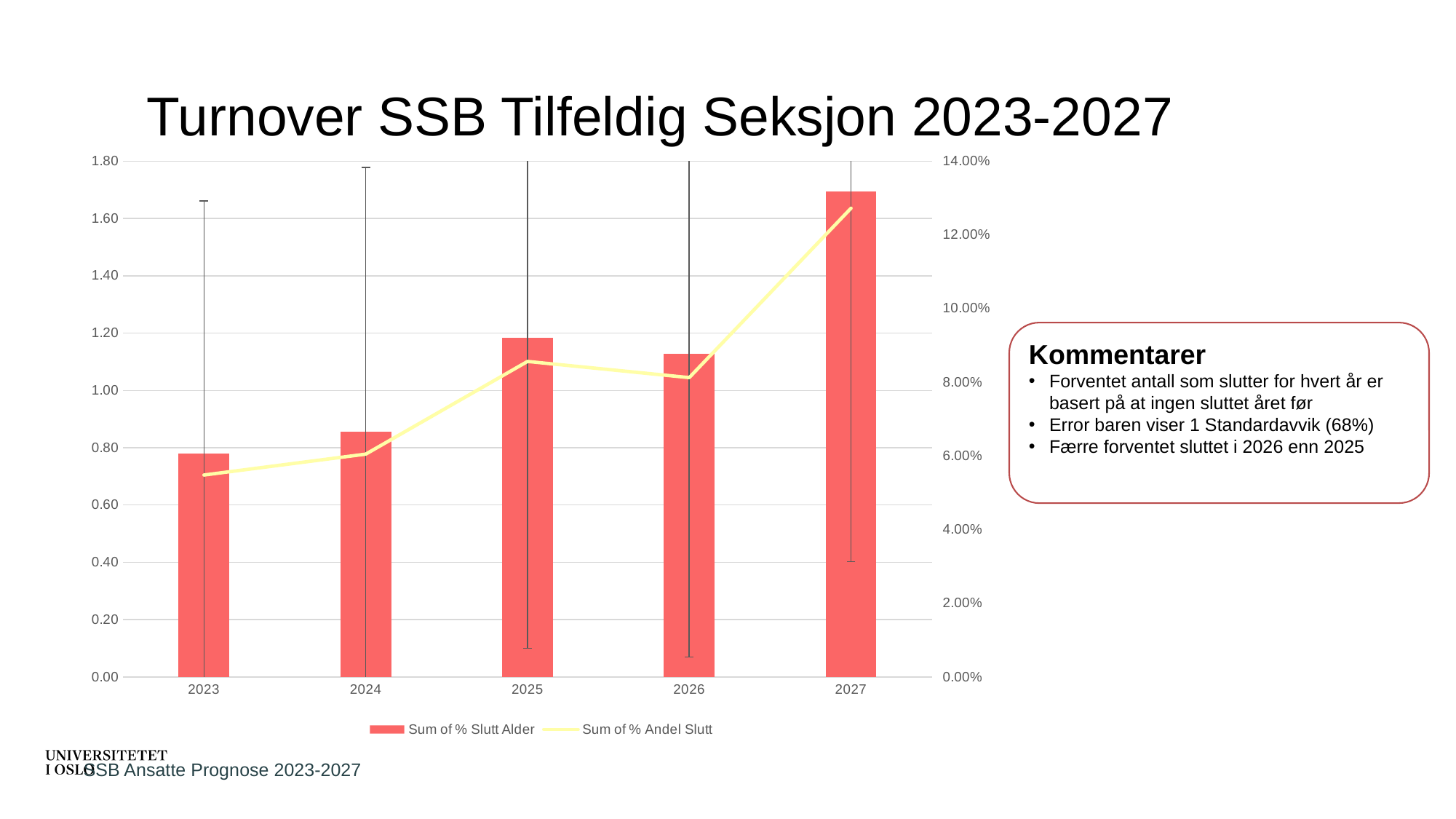
How many series does the legend list? 2 Is the Sum of % Andel Slutt value for 2027 greater or less than 12.00%? greater Is the Sum of % Slutt Alder bar for 2023 greater or less than 1.00? less Which year has the lowest bar for Sum of % Slutt Alder? 2023 Which year has the taller Sum of % Slutt Alder bar, 2025 or 2026? 2025 Is the Sum of % Slutt Alder bar for 2027 greater or less than 1.60? greater What are the two series named in the legend? Sum of % Slutt Alder and Sum of % Andel Slutt Which year has the highest bar for Sum of % Slutt Alder? 2027 What kind of chart is shown on the slide? A combined bar and line chart Does the Sum of % Andel Slutt line rise or fall between 2026 and 2027? rise How many years are shown on the x axis? 5 What is the title of the chart? Turnover SSB Tilfeldig Seksjon 2023-2027